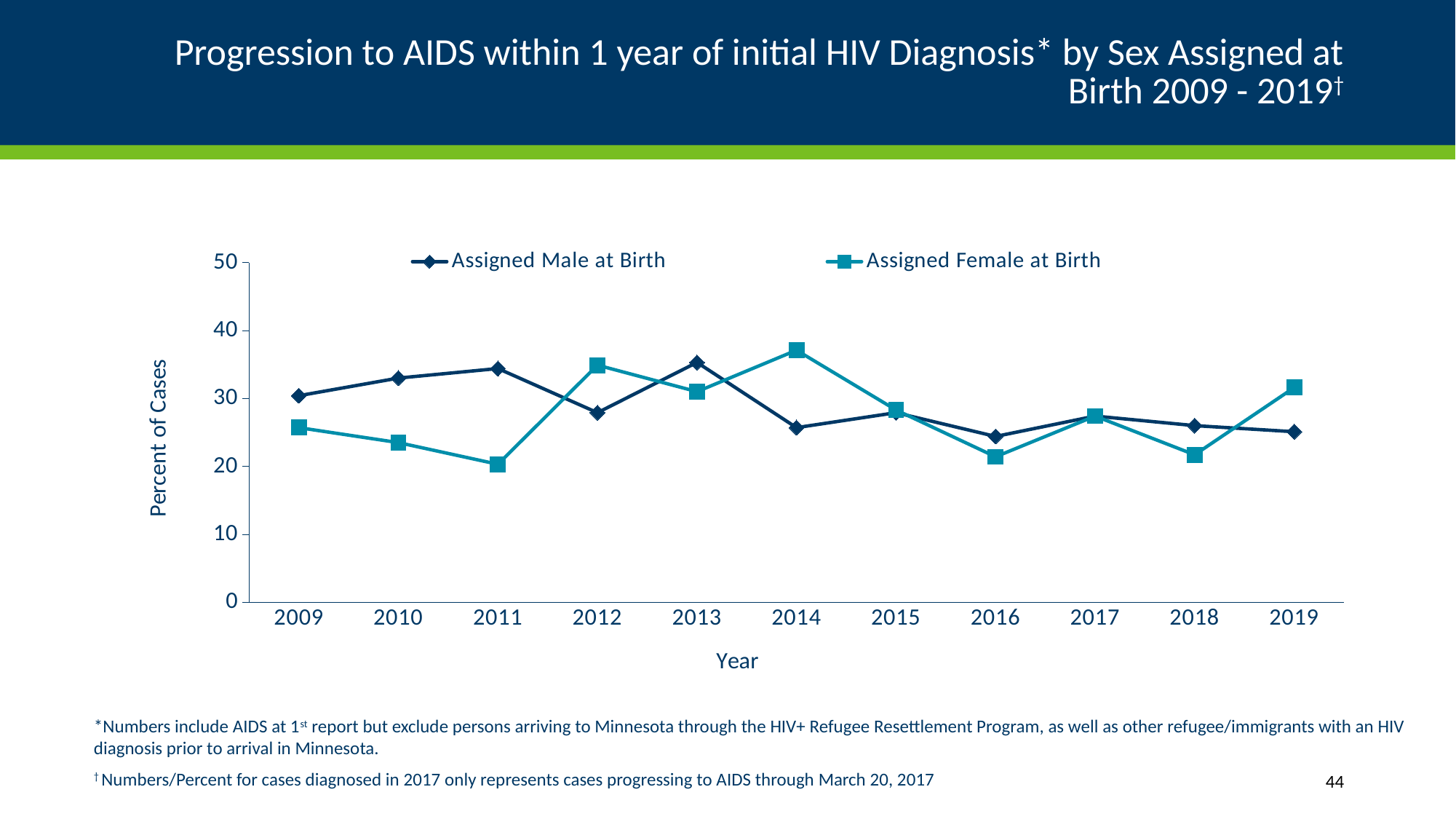
Is the value for Assigned Female at Birth in 2014 greater or less than 30? greater What kind of chart is shown on the slide? line chart In which year does the Assigned Female at Birth series reach its highest value? 2014 What is the label of the vertical axis? Percent of Cases Is the value for Assigned Male at Birth in 2016 greater or less than 30? less Does the Assigned Female at Birth series rise or fall from 2009 to 2011? fall In 2011, which series has the higher value, Assigned Male at Birth or Assigned Female at Birth? Assigned Male at Birth In 2014, which series has the higher value, Assigned Male at Birth or Assigned Female at Birth? Assigned Female at Birth Is the value for Assigned Female at Birth in 2011 greater or less than 30? less Which series is drawn with square markers? Assigned Female at Birth How many series does the legend list? 2 How many years are plotted along the x axis? 11